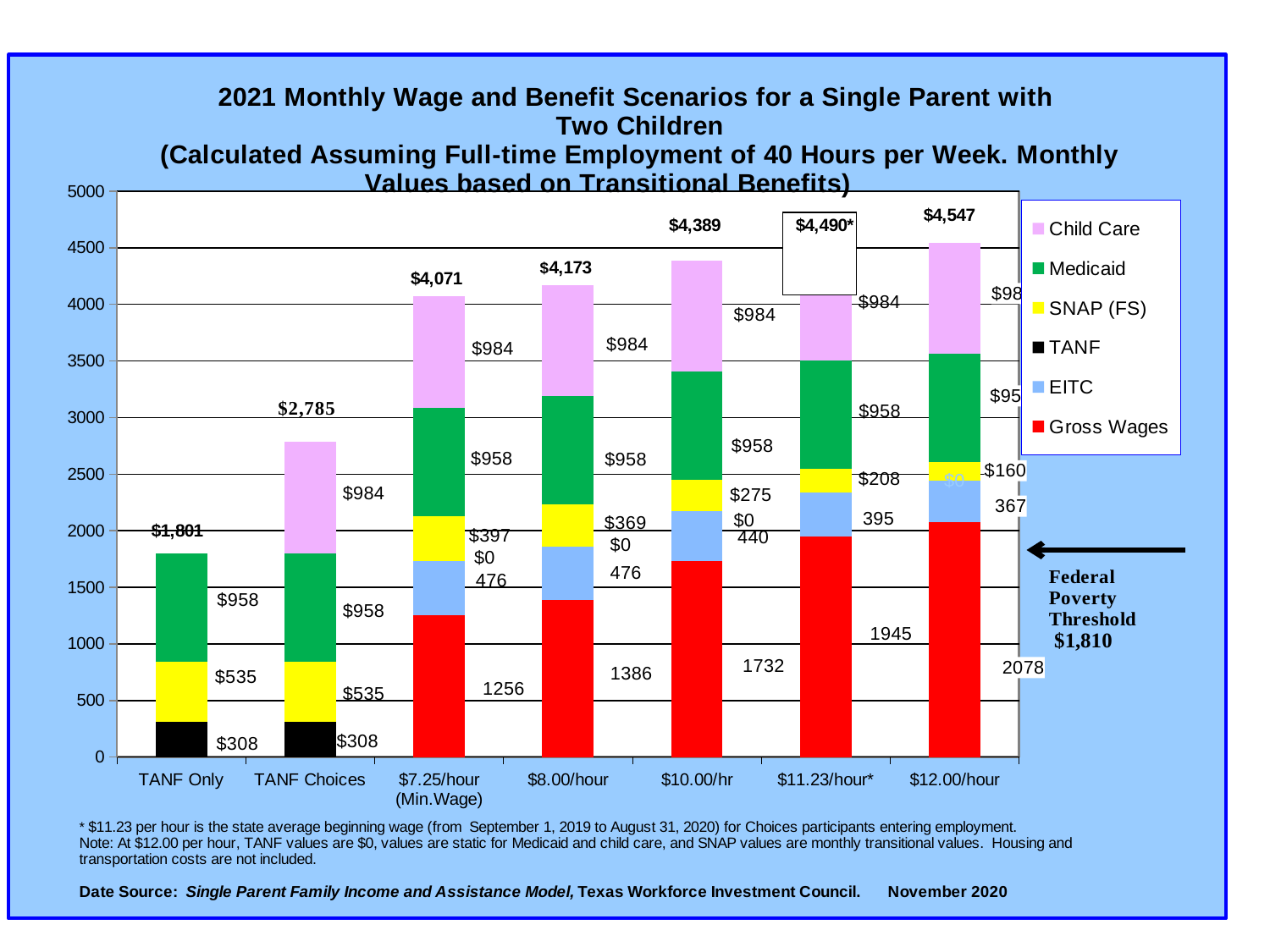
How many series does the legend list? 6 What is the EITC value for the $11.23/hour* scenario? 395 Which scenario has the highest total monthly value? $12.00/hour What kind of chart is shown on the slide? Stacked bar chart How many wage/benefit scenarios (categories) are shown along the x axis? 7 Which scenario has the lowest total monthly value? TANF Only What Federal Poverty Threshold value is indicated by the arrow on the chart? $1,810 What is the Gross Wages value for the $10.00/hr scenario? 1732 What is the difference in Gross Wages between the $12.00/hour scenario and the $7.25/hour (Min.Wage) scenario? 822 What is the total monthly value shown above the $8.00/hour bar? $4,173 Which scenario has a larger SNAP (FS) value, $7.25/hour (Min.Wage) or $10.00/hr? $7.25/hour (Min.Wage) What is the Child Care value for the TANF Choices scenario? $984